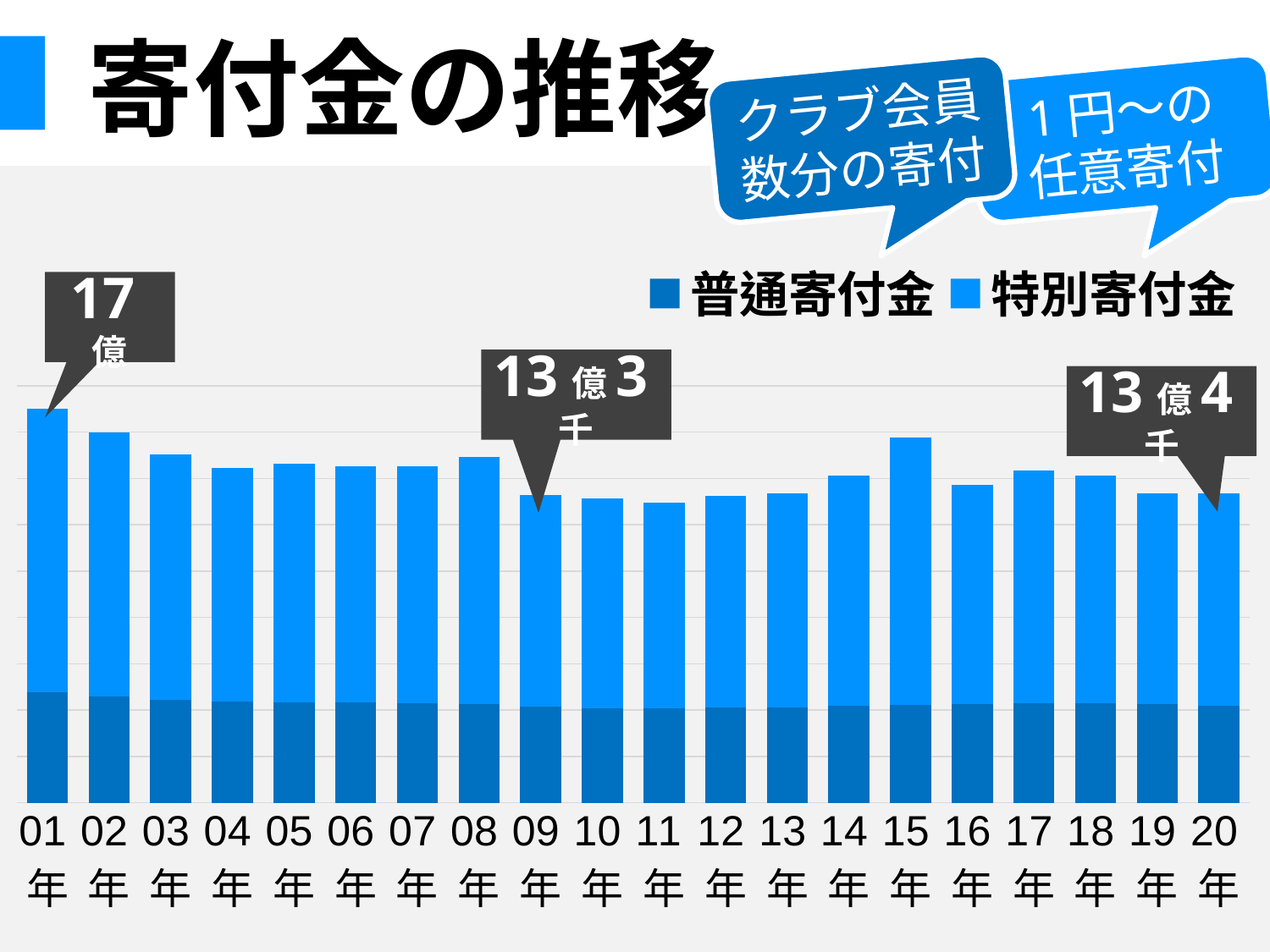
Which is larger, the total bar for 15年 or for 16年? 15年 How many years (categories) are shown on the x axis? 20 What are the two series named in the legend? 普通寄付金, 特別寄付金 What total value is labelled for 01年? 17億 What total value is labelled for 20年? 13億4千 What total value is labelled for 09年? 13億3千 Which is larger, the total for 09年 or the total for 20年? 20年 How many series does the legend list? 2 Which year has the highest total bar? 01年 What kind of chart is shown on the slide? bar chart Do the total bars rise or fall from 01年 to 09年? fall What is the title of the chart? 寄付金の推移